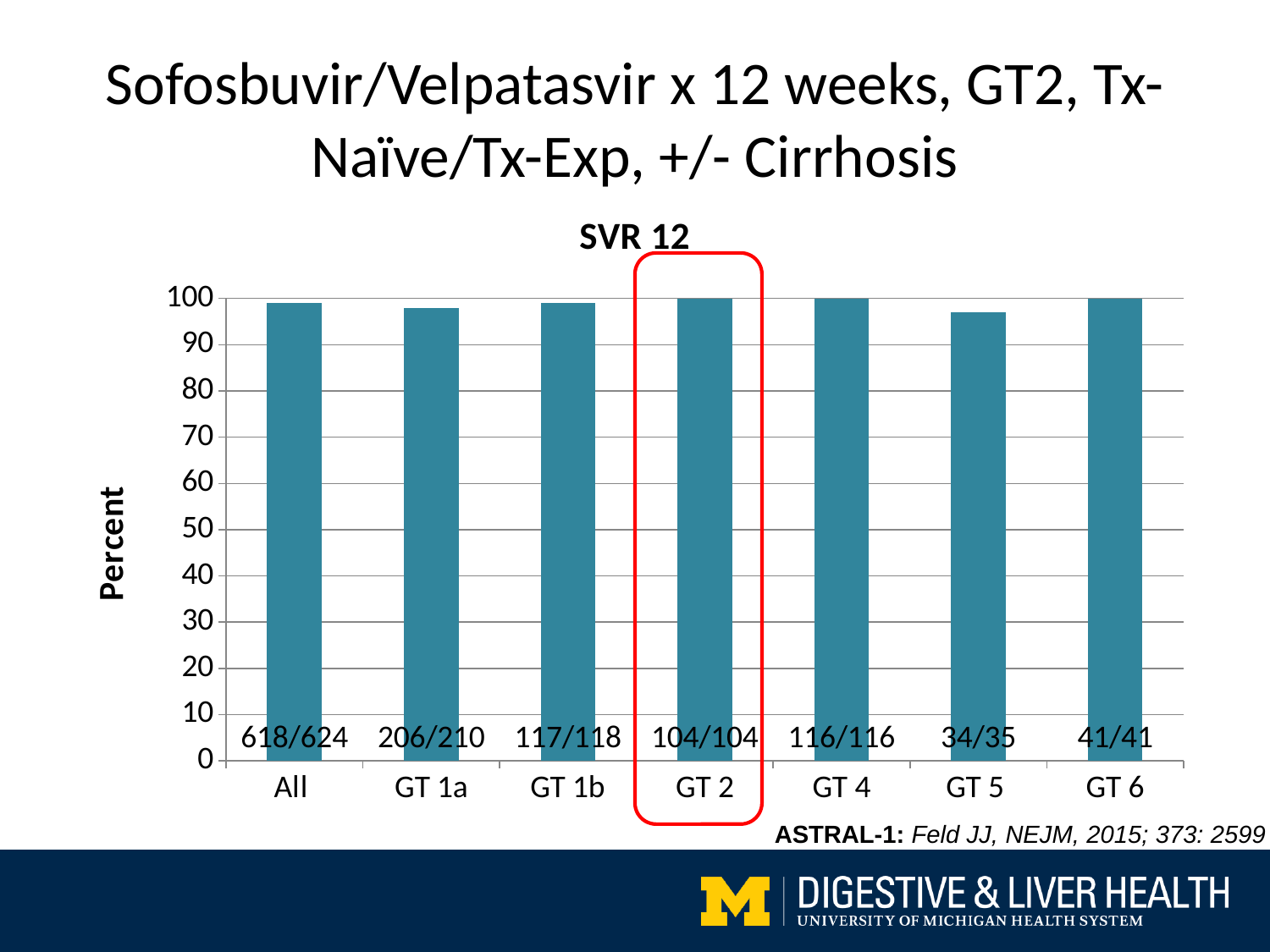
Is the value for GT 1b greater or less than 80? greater Is the value for GT 5 greater or less than 90? greater What is the title of the chart? SVR 12 What kind of chart is shown on the slide? Bar chart What label is printed on the bar for GT 6? 41/41 Which category is highlighted with a red box? GT 2 How many categories are shown on the x axis? 7 Which bar is taller, GT 2 or GT 5? GT 2 What label is printed on the bar for GT 1a? 206/210 What label is printed on the bar for GT 5? 34/35 What label is printed on the bar for All? 618/624 What label is printed on the bar for GT 2? 104/104